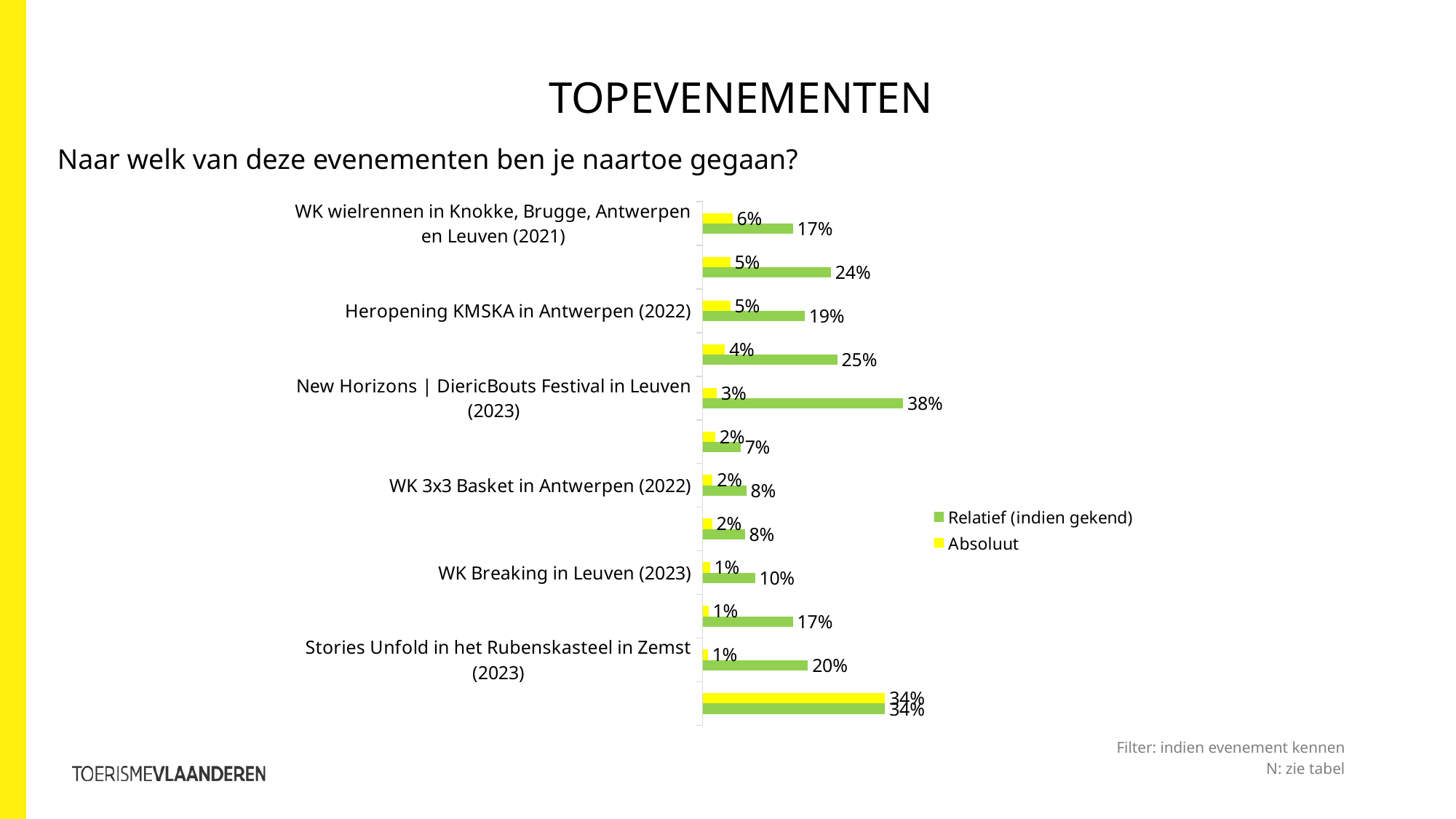
What is the 'Relatief (indien gekend)' value for Stories Unfold in het Rubenskasteel in Zemst (2023)? 20% What is the difference between the 'Relatief (indien gekend)' values for Heropening KMSKA in Antwerpen (2022) and WK wielrennen in Knokke, Brugge, Antwerpen en Leuven (2021)? 2 percentage points What is the 'Absoluut' value for WK Breaking in Leuven (2023)? 1% What is the 'Absoluut' value for WK wielrennen in Knokke, Brugge, Antwerpen en Leuven (2021)? 6% Which has the larger 'Relatief (indien gekend)' value: WK 3x3 Basket in Antwerpen (2022) or WK Breaking in Leuven (2023)? WK Breaking in Leuven (2023) What kind of chart is shown on the slide? Bar chart Which colour represents the 'Absoluut' series? Yellow What is the difference between the 'Relatief (indien gekend)' and 'Absoluut' values for New Horizons | DiericBouts Festival in Leuven (2023)? 35 percentage points Which event has the highest 'Relatief (indien gekend)' value? New Horizons | DiericBouts Festival in Leuven (2023) How many series does the legend list? 2 What is the 'Relatief (indien gekend)' value for New Horizons | DiericBouts Festival in Leuven (2023)? 38% What is the 'Relatief (indien gekend)' value for Heropening KMSKA in Antwerpen (2022)? 19%